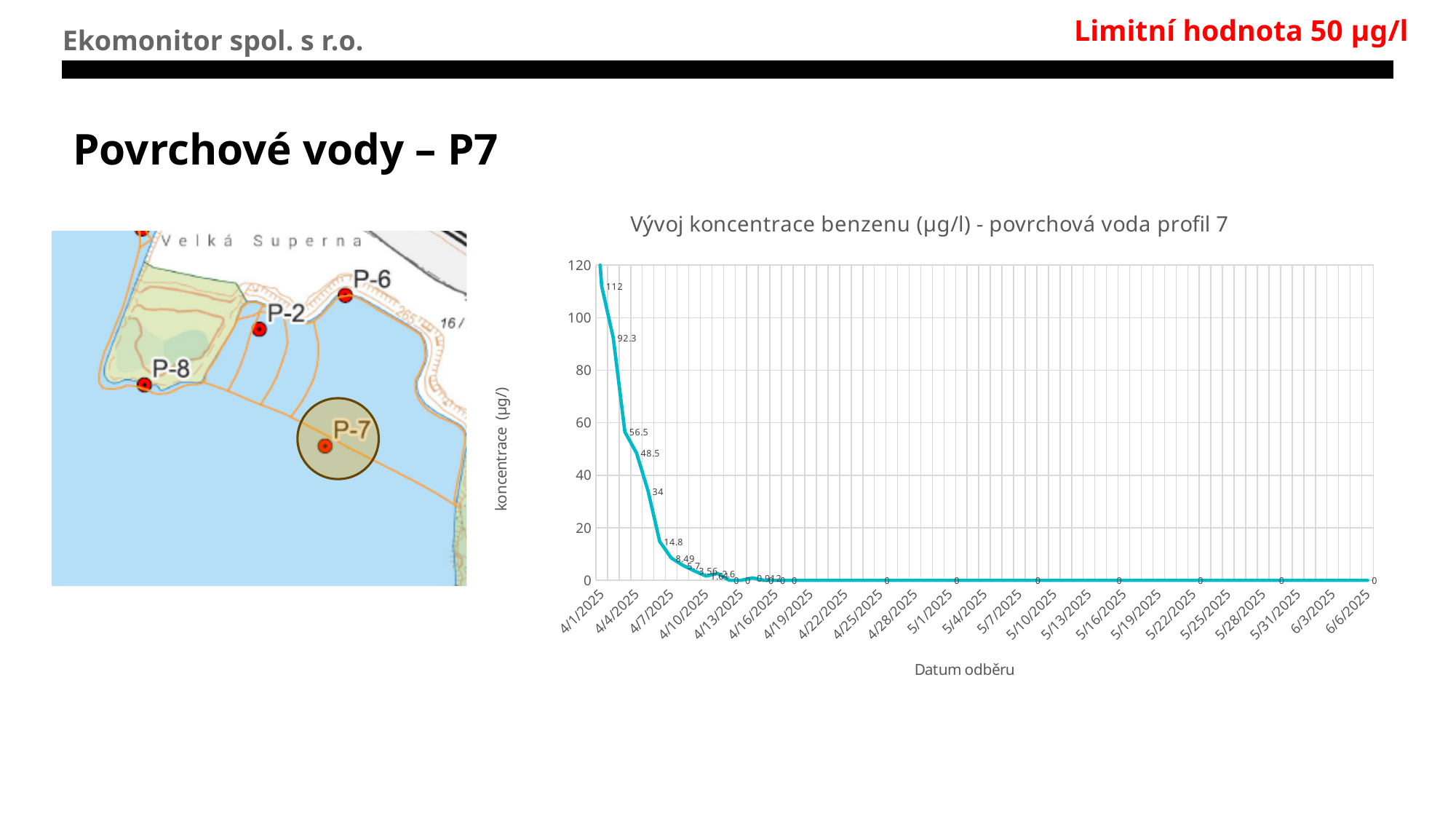
What is the lowest labelled value on the chart? 0 Do the values rise or fall along the x axis from 4/1/2025 onward? fall Is the value for 6/6/2025 greater or less than 20? less What is the highest labelled value on the chart? 112 What is the difference between the first labelled value (112) and the second labelled value (92.3)? 19.7 What is the benzene concentration on 4/1/2025? 112 Is the value for 4/1/2025 greater or less than 100? greater How many date labels are shown on the x axis? 23 What is the title of the chart? Vývoj koncentrace benzenu (µg/l) - povrchová voda profil 7 Which is larger, the value on 4/1/2025 or the value on 6/6/2025? 4/1/2025 What type of chart is shown on the slide? line chart What is the label of the y axis? koncentrace (µg/l)